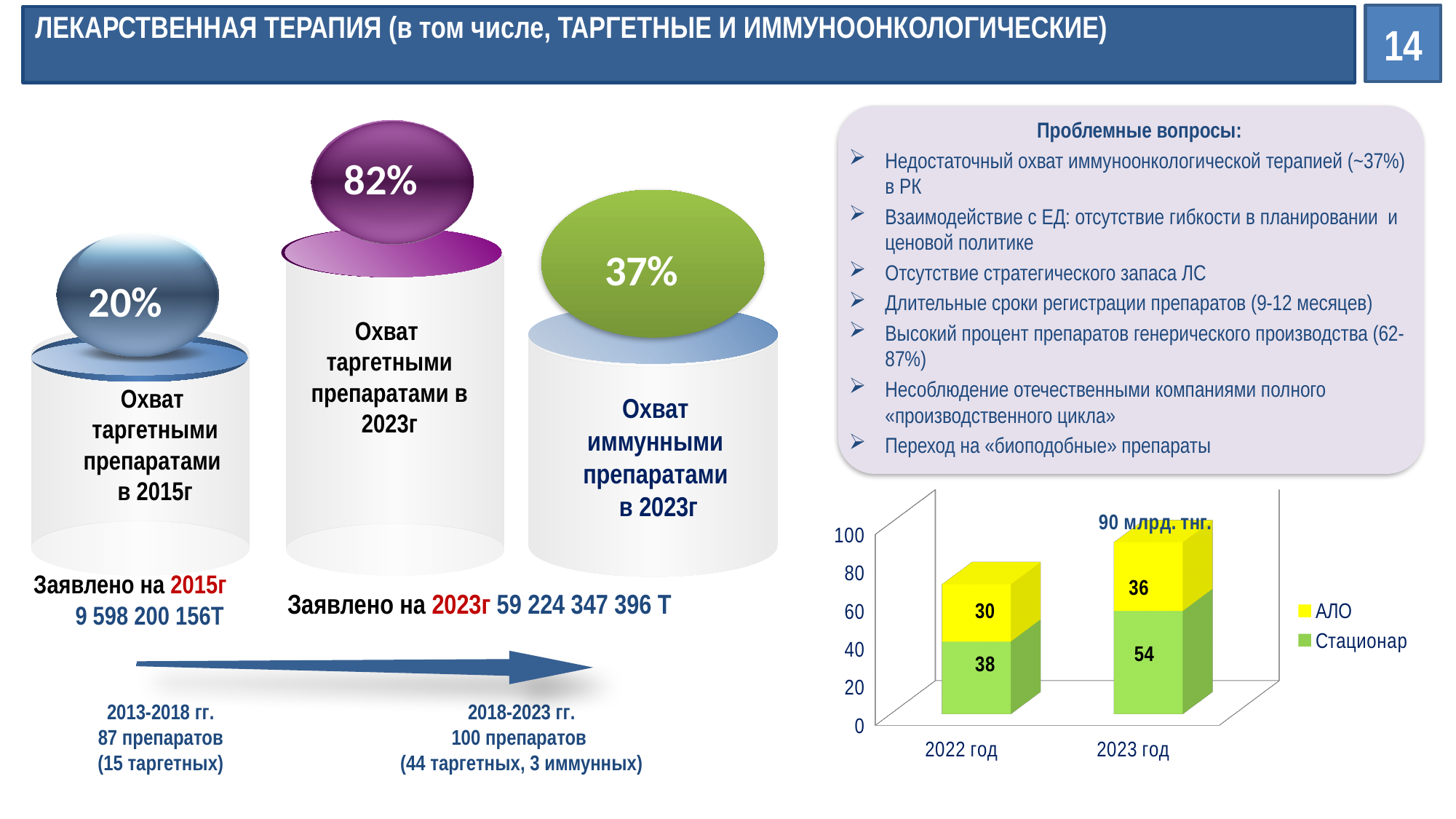
What is the value for АЛО in 2023 год? 36 What is the total of the stacked bar for 2022 год? 68 What kind of chart is shown on the slide? Stacked bar chart Which colour represents АЛО in the chart? Yellow What is the value for АЛО in 2022 год? 30 Which is larger in 2023 год, АЛО or Стационар? Стационар What is the value for Стационар in 2023 год? 54 What is the value for Стационар in 2022 год? 38 How many categories are shown on the x axis? 2 What is the difference between the Стационар values for 2023 год and 2022 год? 16 What is the total of the stacked bar for 2023 год? 90 How many series does the legend list? 2